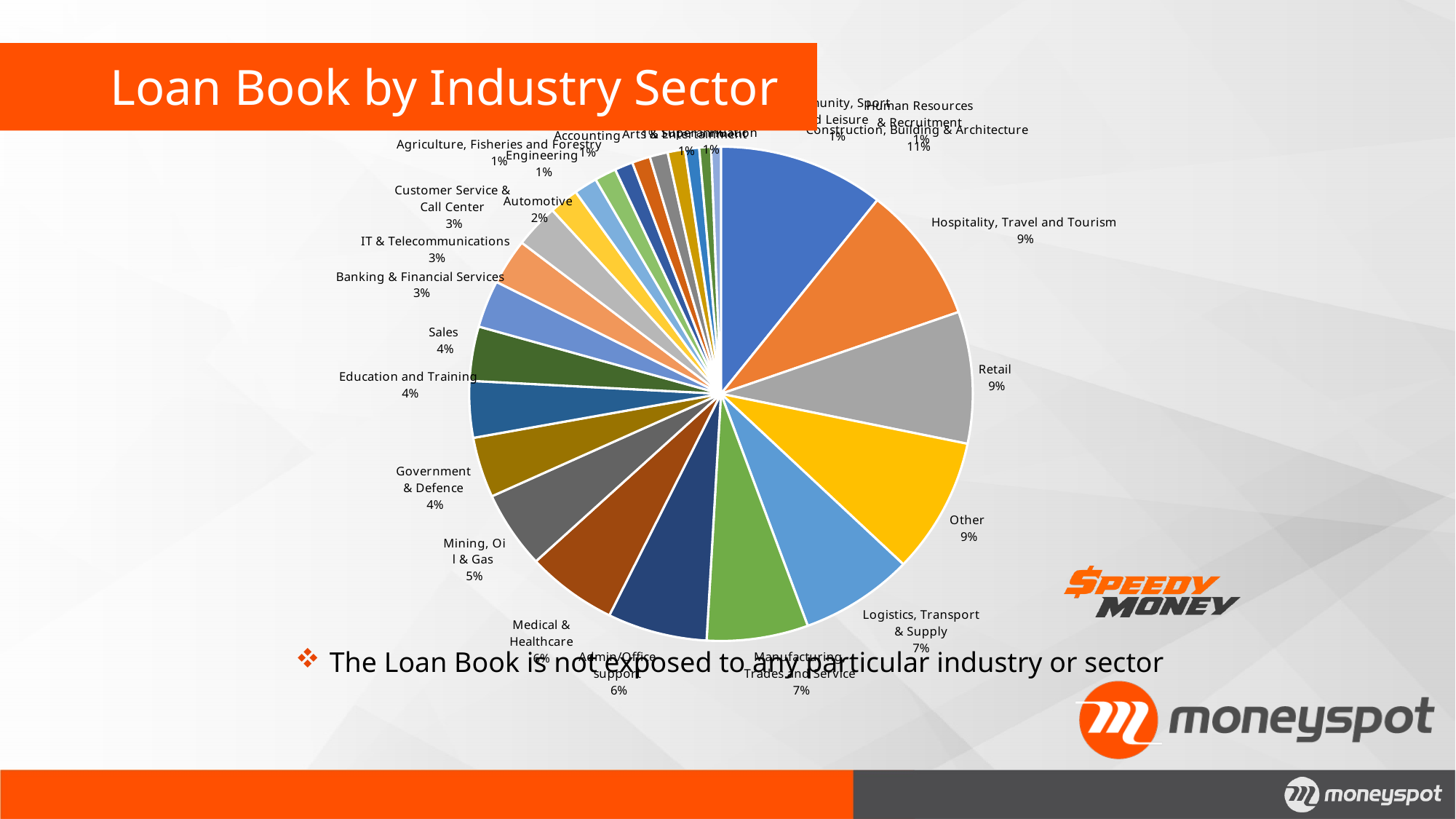
What share of the loan book is Construction, Building & Architecture? 11% What is the difference in percentage points between Construction, Building & Architecture and Hospitality, Travel and Tourism? 2% What is the title of the chart on the slide? Loan Book by Industry Sector What percentage is shown for Mining, Oil & Gas? 5% What percentage is shown for Banking & Financial Services? 3% Which industry sector has the largest share of the loan book? Construction, Building & Architecture Which has a larger share, Admin/Office support or Education and Training? Admin/Office support Which has a larger share, Mining, Oil & Gas or Sales? Mining, Oil & Gas What kind of chart is shown on the slide? pie chart What percentage is shown for Logistics, Transport & Supply? 7% What share of the loan book is Retail? 9% What percentage is shown for Automotive? 2%